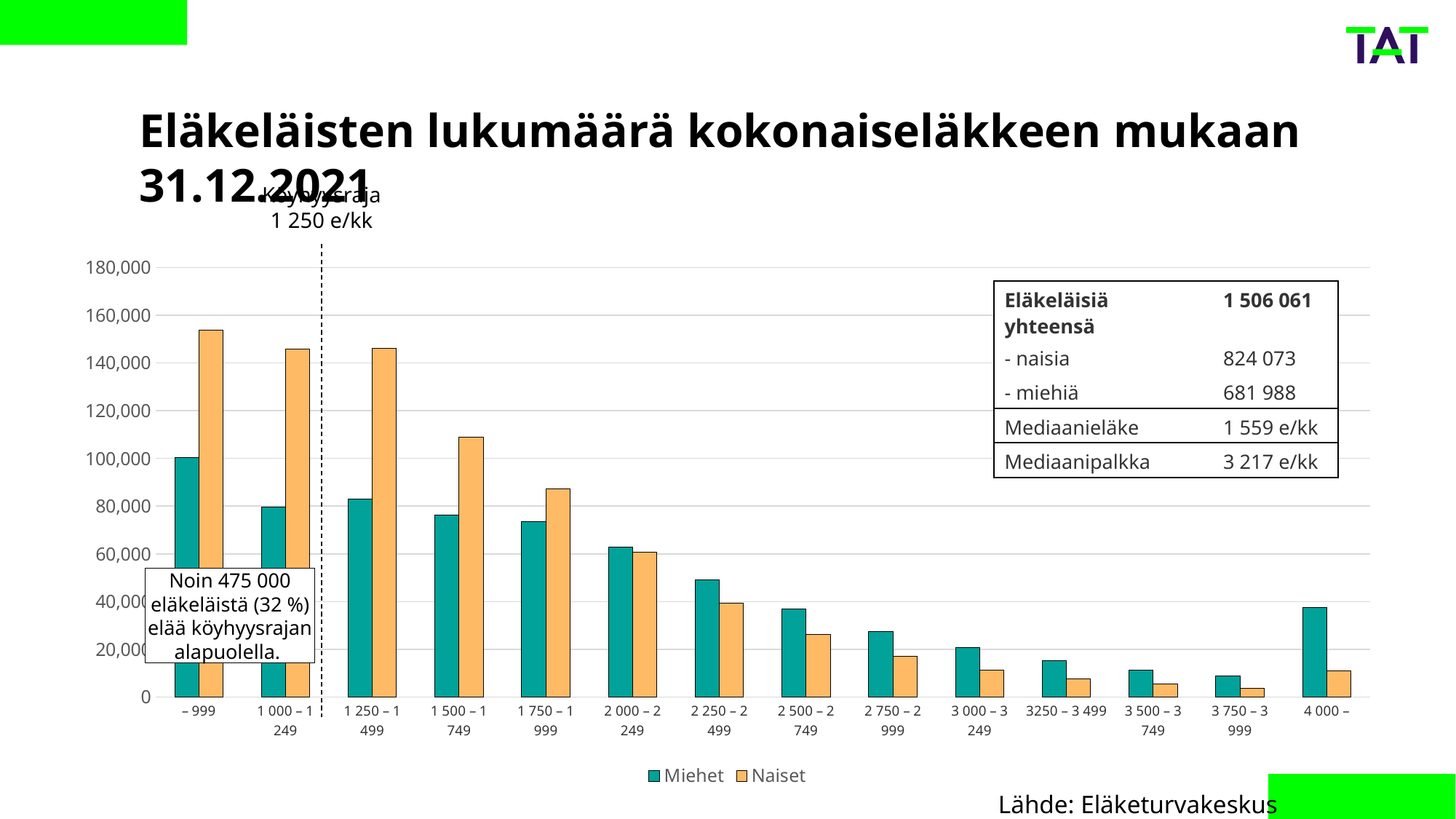
How many series does the legend list? 2 Is the value for Naiset in the 1 500 – 1 749 category greater or less than 100,000? greater In the 4 000 – category, which series has the larger value, Miehet or Naiset? Miehet How many pension-range categories are shown on the x axis? 14 Which category has the lowest value for Miehet? 3 750 – 3 999 Is the value for Naiset in the – 999 category greater or less than 140,000? greater Do the Naiset values rise or fall from the 1 250 – 1 499 category to the 3 750 – 3 999 category? fall What are the two series named in the legend? Miehet and Naiset Is the value for Miehet in the 2 250 – 2 499 category greater or less than 60,000? less Which category has the highest value for Naiset? – 999 What kind of chart is shown on the slide? bar chart Which category has the highest value for Miehet? – 999